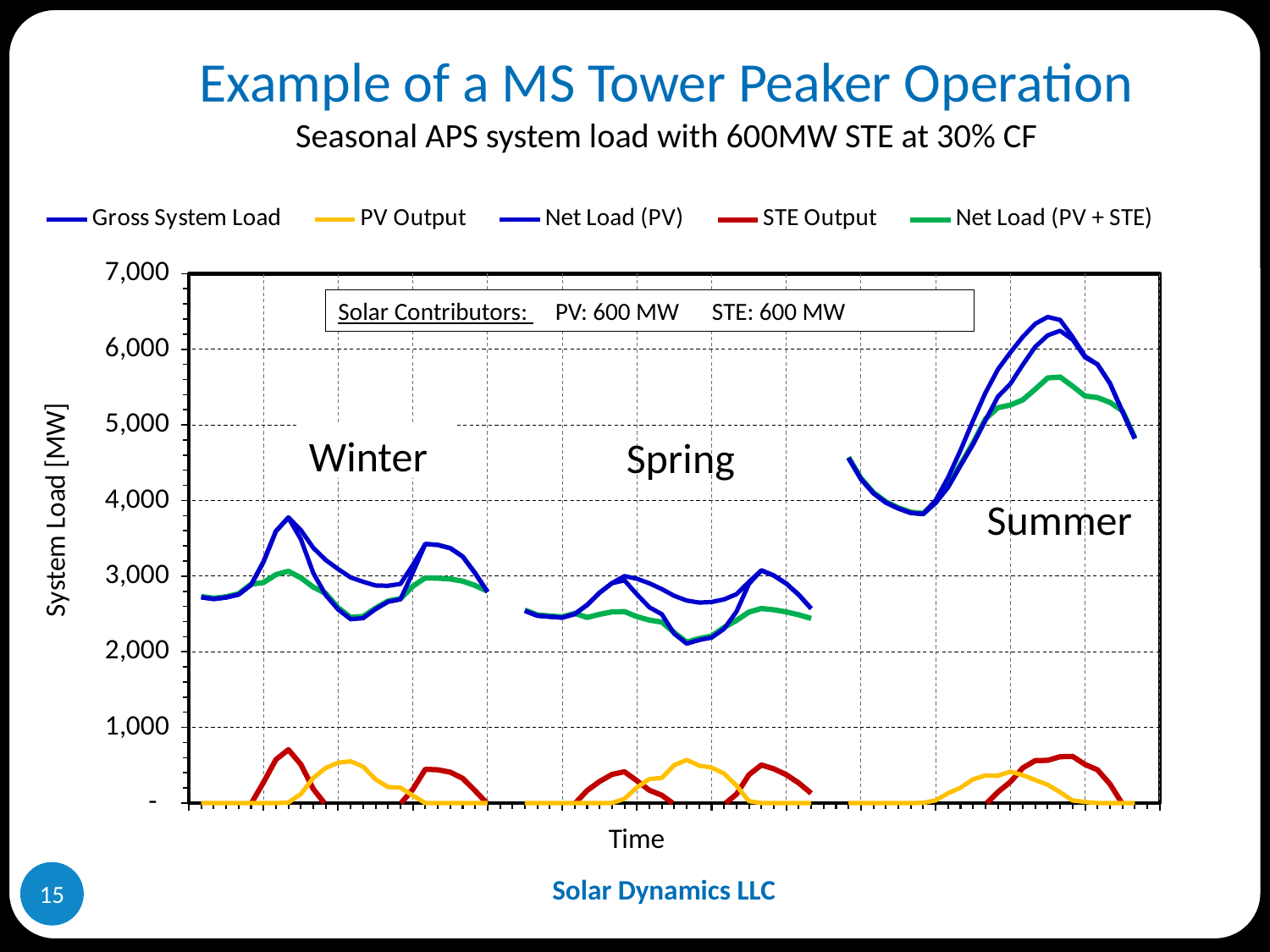
How many seasons are labelled on the chart? 3 Is the peak PV Output in Summer greater or less than 1,000? less According to the text box on the chart, what is the STE solar contribution? 600 MW Is the peak Net Load (PV + STE) in Summer greater or less than 5,000? greater What is the label of the y axis? System Load [MW] How many series does the legend list? 5 Which season shows the highest peak in Gross System Load? Summer Is the peak Gross System Load in Summer greater or less than 6,000? greater What kind of chart is shown on the slide? line chart Which season shows the lowest peak in Gross System Load? Spring Which is larger in Summer, the peak Gross System Load or the peak Net Load (PV + STE)? Gross System Load